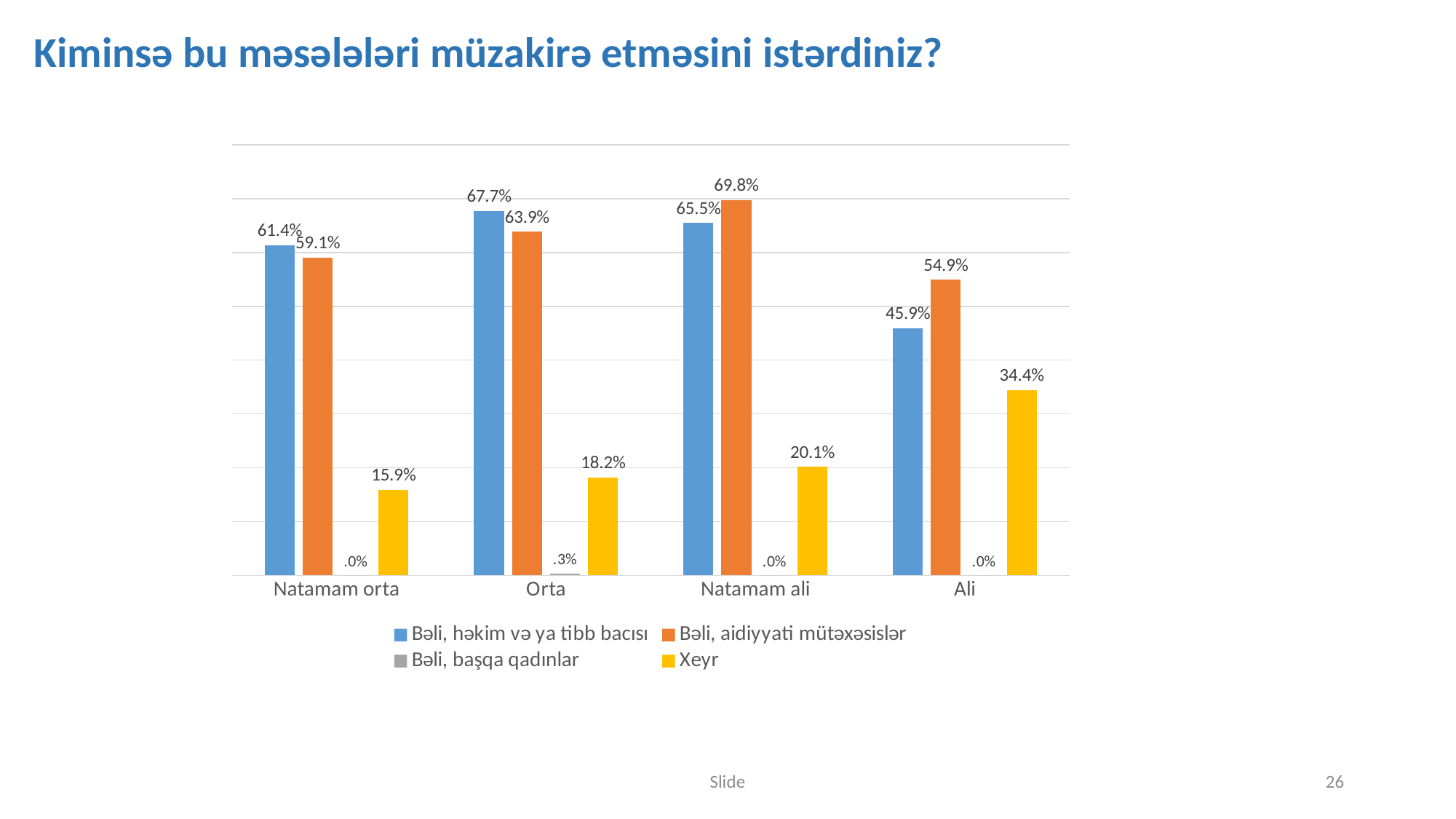
What is the difference between 'Bəli, aidiyyati mütəxəsislər' and 'Bəli, həkim və ya tibb bacısı' in the Ali category? 9.0% Which category has the highest value for 'Xeyr'? Ali How many series does the legend list? 4 What is the value for 'Xeyr' in the Ali category? 34.4% What is the value for 'Bəli, aidiyyati mütəxəsislər' in the Natamam ali category? 69.8% What is the value for 'Bəli, həkim və ya tibb bacısı' in the Orta category? 67.7% How many categories are shown on the x axis? 4 In the Natamam orta category, which is larger: 'Bəli, həkim və ya tibb bacısı' or 'Bəli, aidiyyati mütəxəsislər'? Bəli, həkim və ya tibb bacısı What kind of chart is shown on the slide? bar chart What is the title of the chart on the slide? Kiminsə bu məsələləri müzakirə etməsini istərdiniz? Which category has the lowest value for 'Bəli, həkim və ya tibb bacısı'? Ali What is the value for 'Bəli, başqa qadınlar' in the Orta category? .3%